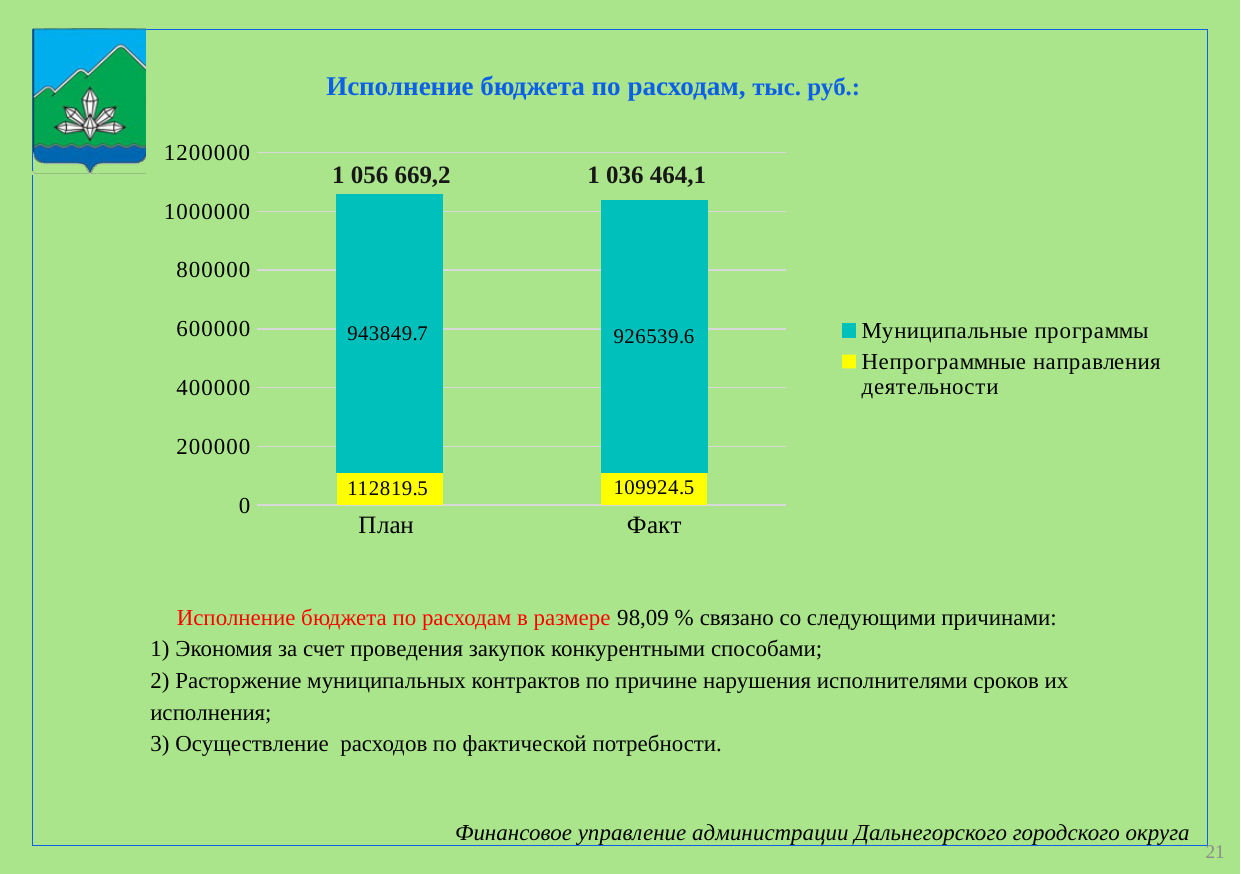
Which category has the larger value for Муниципальные программы, План or Факт? План How many series does the legend list? 2 What is the total of the stacked bar for Факт? 1 036 464,1 What is the title of the chart? Исполнение бюджета по расходам, тыс. руб.: What is the total of the stacked bar for План? 1 056 669,2 Is the total for План greater or less than 1000000? greater What is the value of Муниципальные программы for План? 943849.7 How many categories are shown on the x axis? 2 What kind of chart is shown on the slide? stacked bar chart What is the difference between the Непрограммные направления деятельности values for План and Факт? 2895 What is the value of Непрограммные направления деятельности for Факт? 109924.5 What is the difference between the Муниципальные программы values for План and Факт? 17310.1